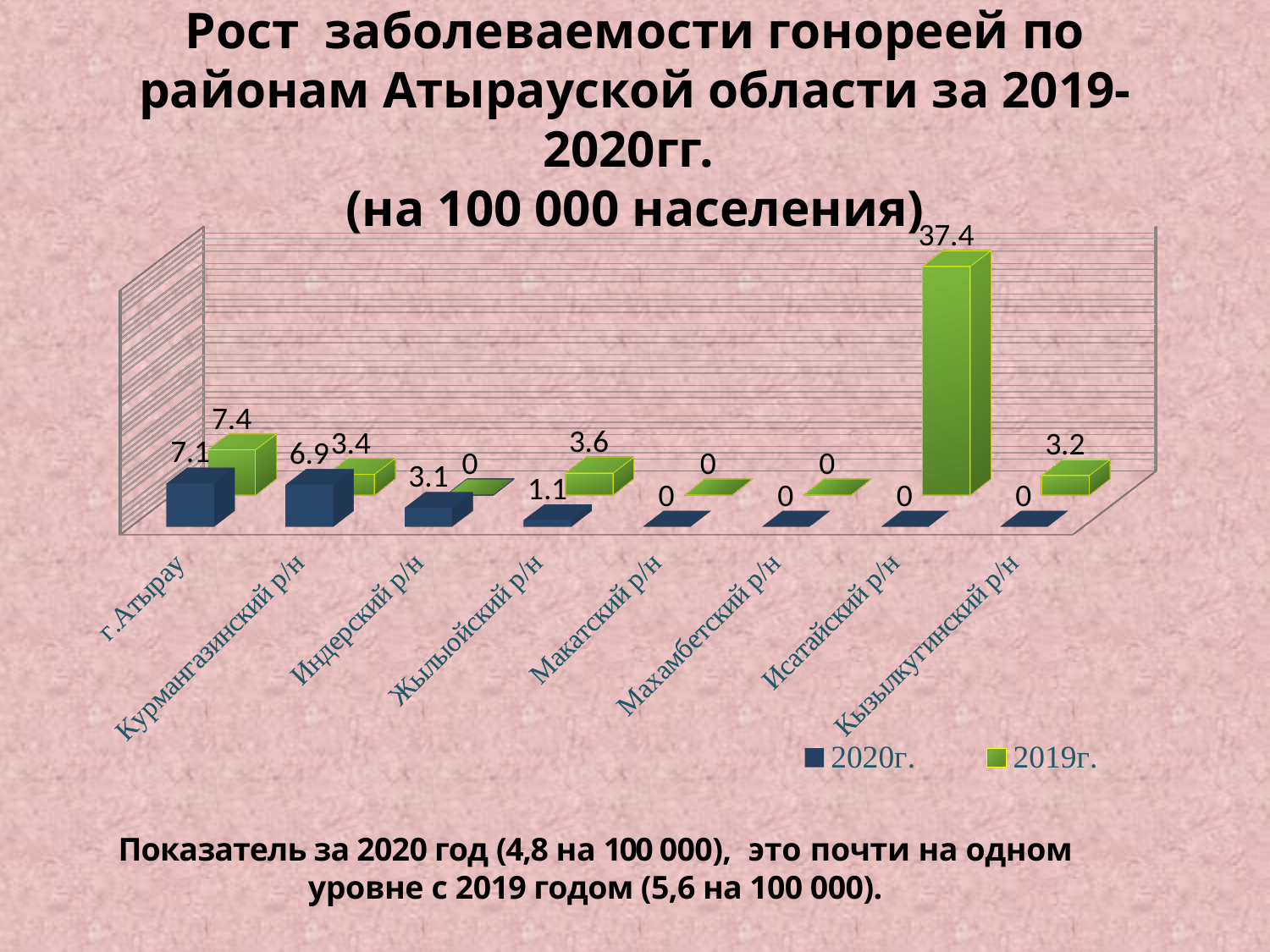
What kind of chart is shown on the slide? Bar chart What is the 2020г. value for г.Атырау? 7.1 How many districts are shown on the x axis? 8 What is the 2019г. value for Исатайский р/н? 37.4 Which is larger for Жылыойский р/н: the 2020г. value or the 2019г. value? 2019г. What is the 2019г. value for Курмангазинский р/н? 3.4 What is the difference between the 2020г. and 2019г. values for Курмангазинский р/н? 3.5 Which colour represents the 2019г. series in the legend? Green Which district has the highest 2019г. value? Исатайский р/н What is the 2020г. value for Жылыойский р/н? 1.1 Which district has the highest 2020г. value? г.Атырау How many series does the legend list? 2